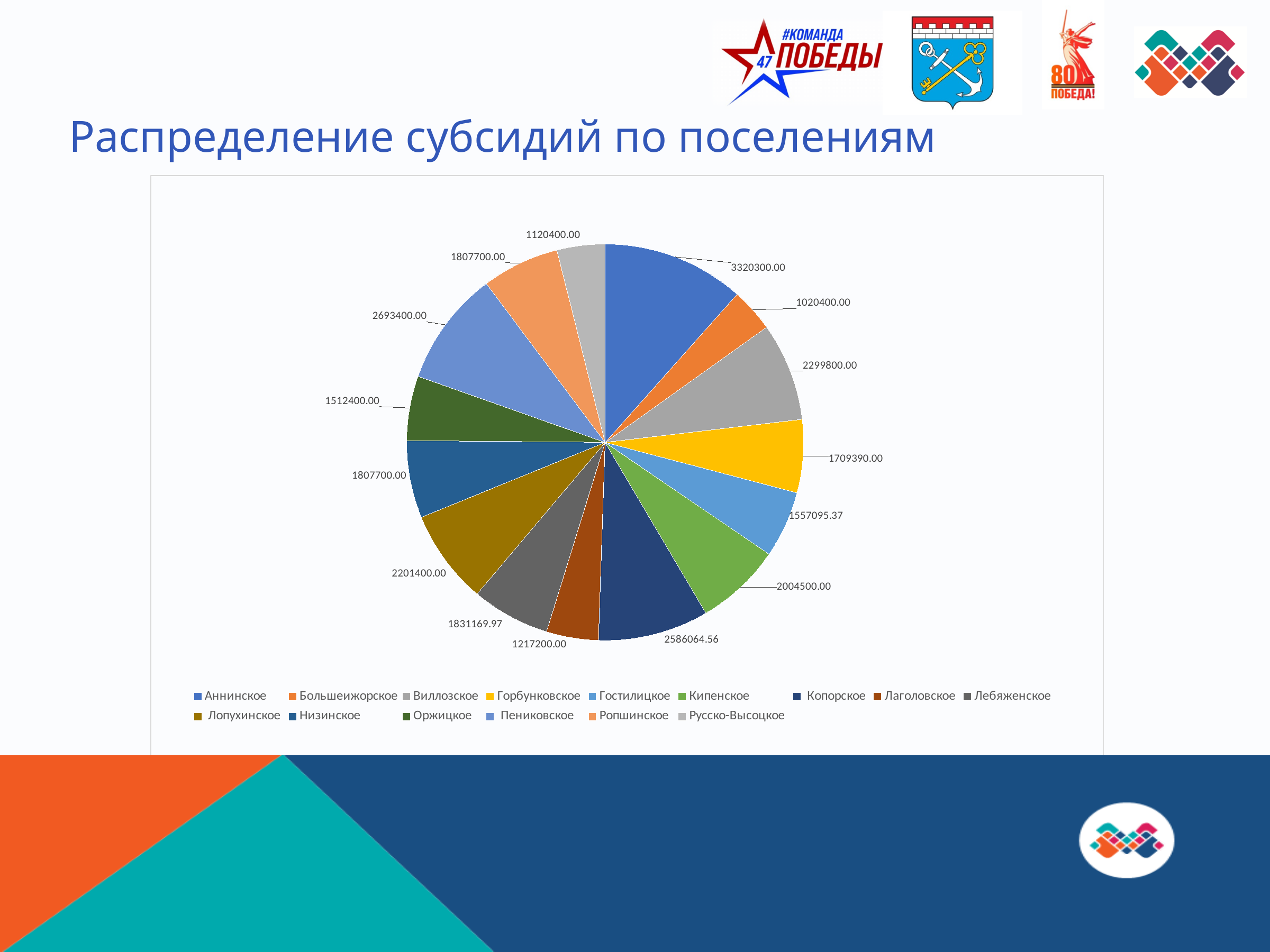
What is the difference between the values for Аннинское and Большеижорское? 2299900.00 What is the value for Лебяженское? 1831169.97 Which settlement has the smallest slice? Большеижорское What kind of chart is shown on the slide? Pie chart What is the title of the chart? Распределение субсидий по поселениям What is the value for Гостилицкое? 1557095.37 How many slices does the pie chart have? 15 Which settlement has the largest slice? Аннинское What is the value for Копорское? 2586064.56 Which is larger, the value for Виллозское or the value for Лопухинское? Виллозское Which two settlements have the same value of 1807700.00? Низинское and Ропшинское What is the value for Аннинское? 3320300.00